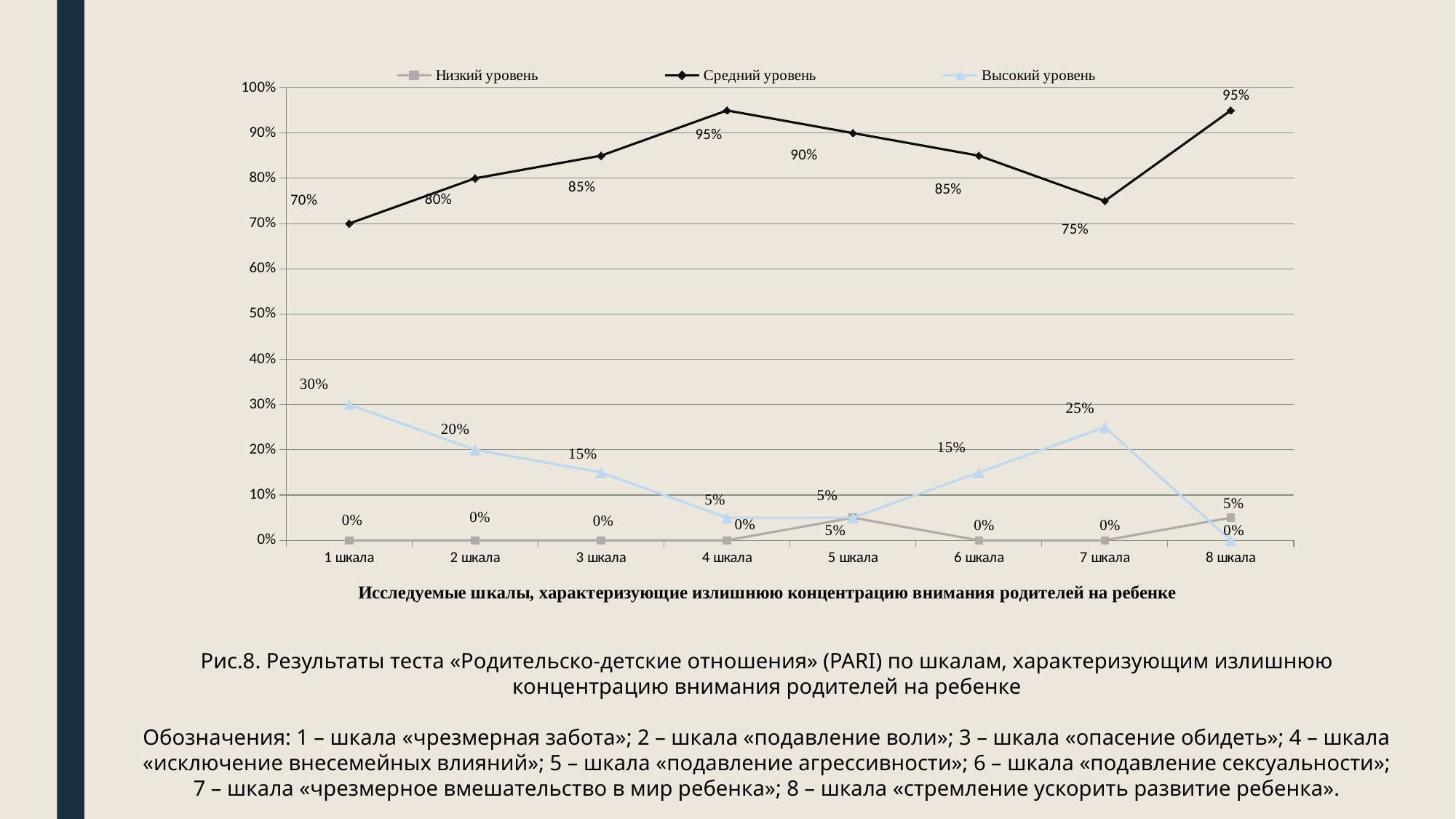
For which category is Средний уровень lowest? 1 шкала Which is larger: Высокий уровень for 7 шкала or for 2 шкала? 7 шкала How many categories (шкалы) are plotted along the x axis? 8 Which series is drawn with the black line and diamond markers? Средний уровень What is the difference between Средний уровень for 4 шкала and for 1 шкала? 25% How many series does the legend list? 3 For which category is Высокий уровень highest? 1 шкала What is the value of Средний уровень for 1 шкала? 70% Does Средний уровень rise or fall from 1 шкала to 4 шкала? Rise What kind of chart is shown on the slide? Line chart What is the value of Низкий уровень for 5 шкала? 5% What is the value of Высокий уровень for 7 шкала? 25%